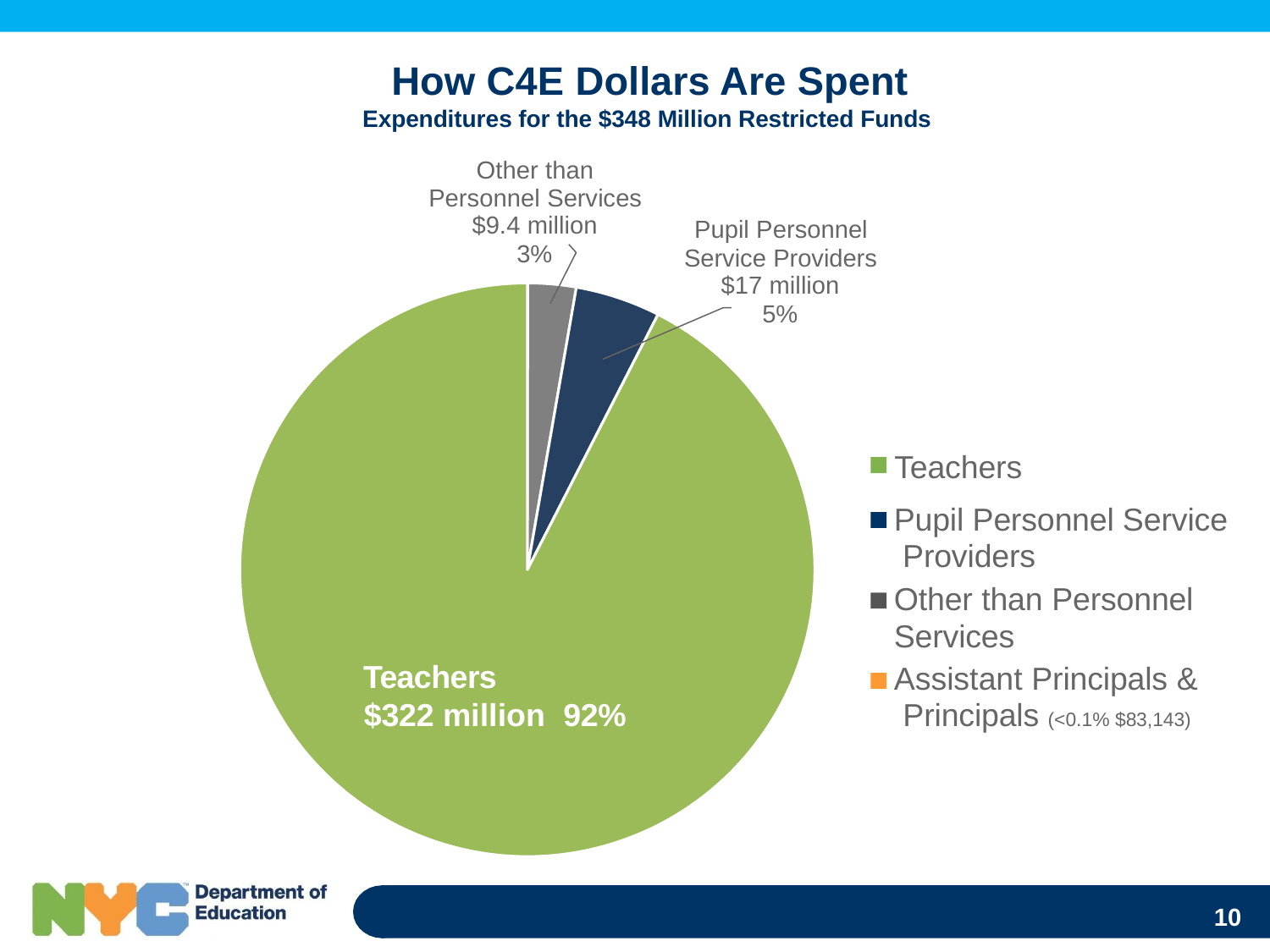
What percentage of the pie is Other than Personnel Services? 3% What dollar amount is spent on Teachers? $322 million What is the difference in percentage points between the Pupil Personnel Service Providers share and the Other than Personnel Services share? 2% Which category has the largest share of the pie? Teachers What is the title of the chart? How C4E Dollars Are Spent What percentage of the pie is Teachers? 92% Which is larger, Pupil Personnel Service Providers or Other than Personnel Services? Pupil Personnel Service Providers What kind of chart is shown on the slide? Pie chart What dollar amount is spent on Other than Personnel Services? $9.4 million What dollar amount is spent on Pupil Personnel Service Providers? $17 million What percentage of the pie is Pupil Personnel Service Providers? 5% How many series does the legend list? 4